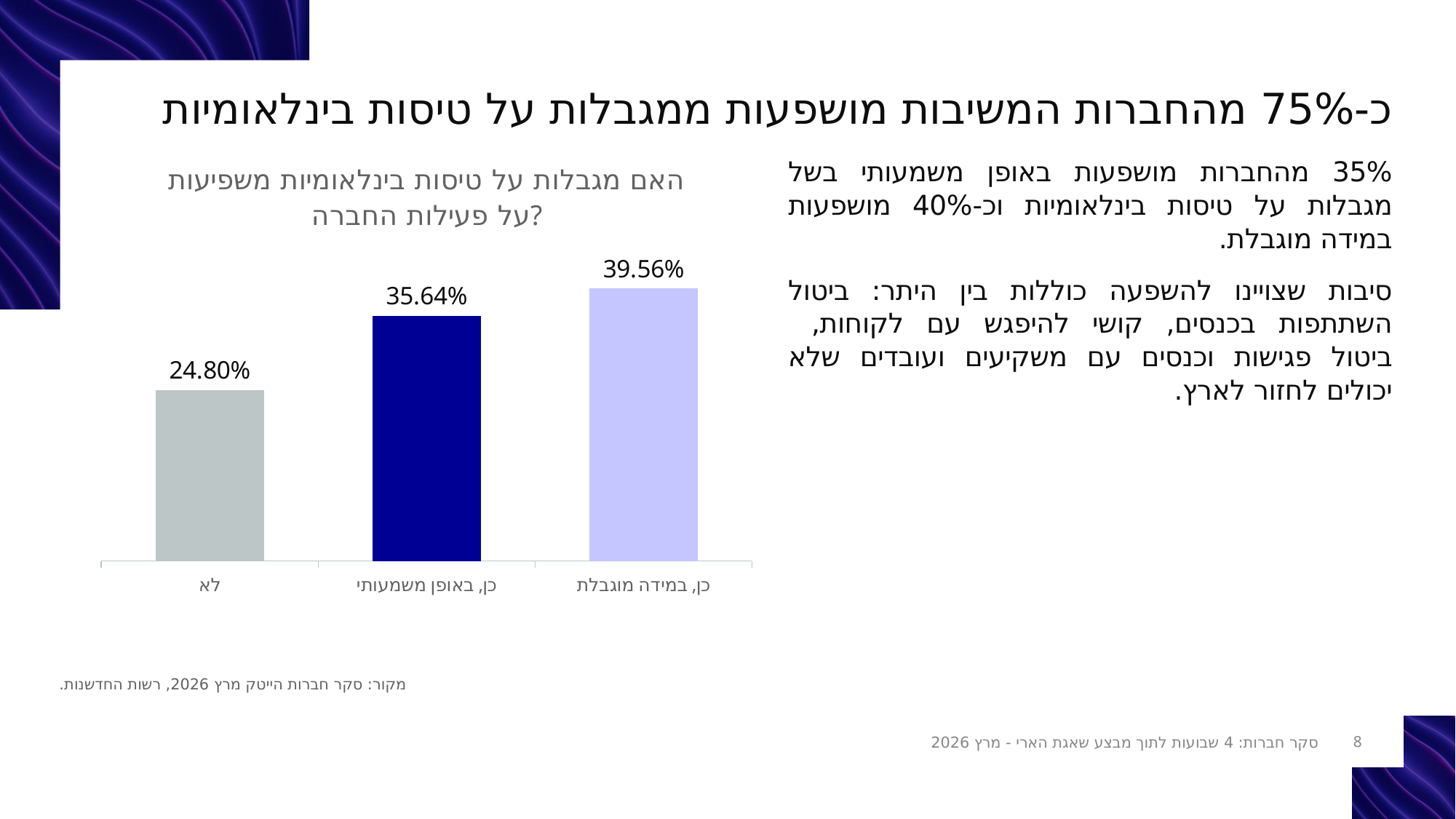
What colour is the bar for "כן, באופן משמעותי"? Dark blue What is the value for the category "כן, במידה מוגבלת"? 39.56% What is the value for the category "כן, באופן משמעותי"? 35.64% What is the title of the chart? האם מגבלות על טיסות בינלאומיות משפיעות על פעילות החברה? Which category has the highest value? כן, במידה מוגבלת What is the difference between the values for "כן, באופן משמעותי" and "לא"? 10.84% Which is larger, the value for "לא" or the value for "כן, באופן משמעותי"? כן, באופן משמעותי Which category has the lowest value? לא What is the difference between the values for "כן, במידה מוגבלת" and "כן, באופן משמעותי"? 3.92% How many categories are shown in the chart? 3 What kind of chart is shown on the slide? Bar chart What is the value for the category "לא"? 24.80%